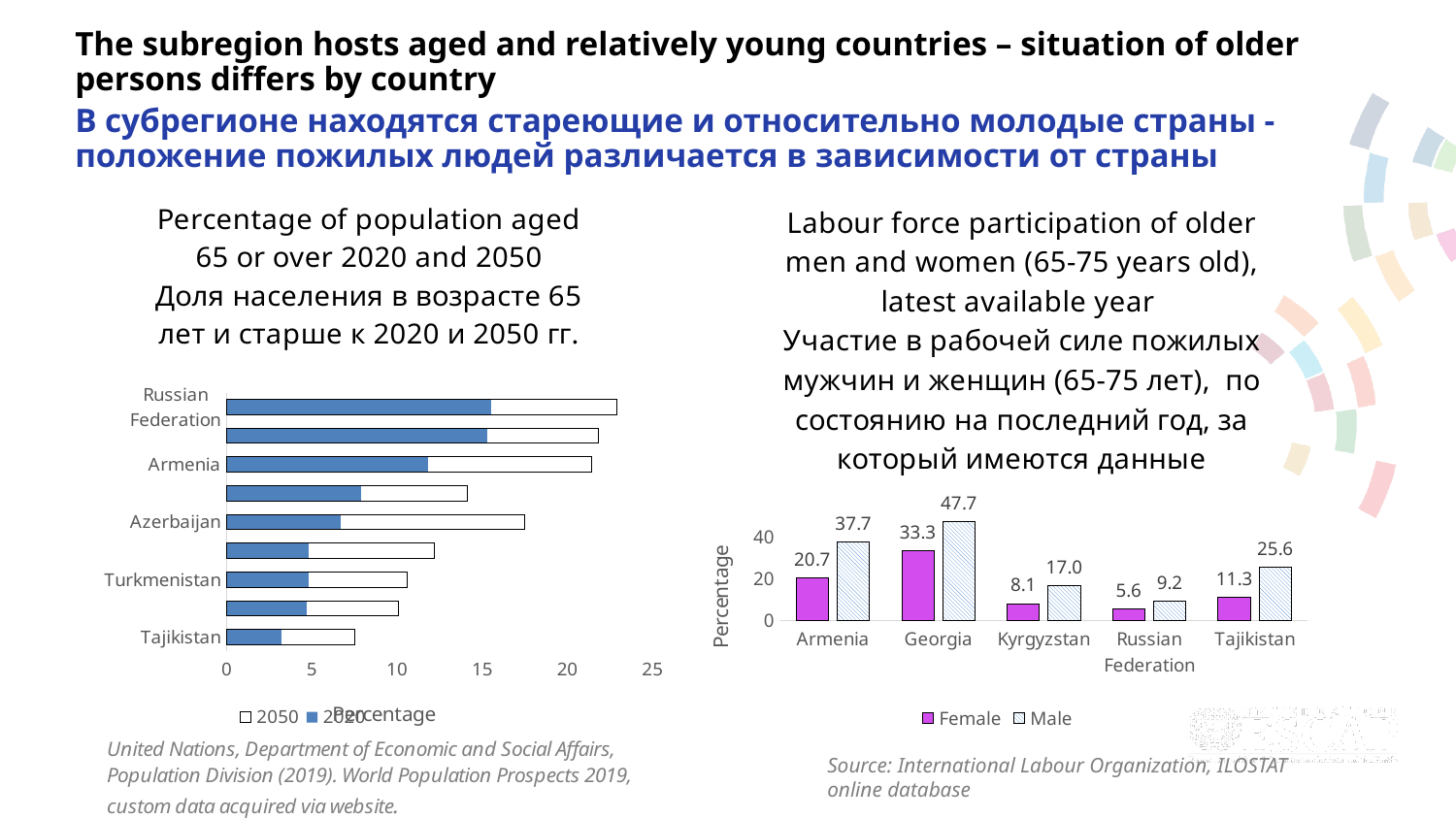
In the chart titled "Percentage of population aged 65 or over 2020 and 2050", is the 2050 value for the Russian Federation greater or less than 20? greater In the chart titled "Percentage of population aged 65 or over 2020 and 2050", what are the two series listed in the legend? 2050 and 2020 In the chart titled "Labour force participation of older men and women (65-75 years old), latest available year", how many countries are shown on the x axis? 5 In the chart titled "Labour force participation of older men and women (65-75 years old), latest available year", what is the value for Female in Georgia? 33.3 In the chart titled "Labour force participation of older men and women (65-75 years old), latest available year", is the Female value for Kyrgyzstan larger or smaller than the Female value for Tajikistan? smaller In the chart titled "Labour force participation of older men and women (65-75 years old), latest available year", what is the difference between the Male and Female values for Armenia? 17.0 In the chart titled "Labour force participation of older men and women (65-75 years old), latest available year", what is the value for Male in Tajikistan? 25.6 In the chart titled "Labour force participation of older men and women (65-75 years old), latest available year", how many series does the legend list? 2 In the chart titled "Labour force participation of older men and women (65-75 years old), latest available year", which country has the highest Male value? Georgia In the chart titled "Labour force participation of older men and women (65-75 years old), latest available year", which country has the lowest Female value? Russian Federation What kind of chart is the one titled "Percentage of population aged 65 or over 2020 and 2050"? bar chart In the chart titled "Percentage of population aged 65 or over 2020 and 2050", is the 2020 value for Tajikistan greater or less than 5? less